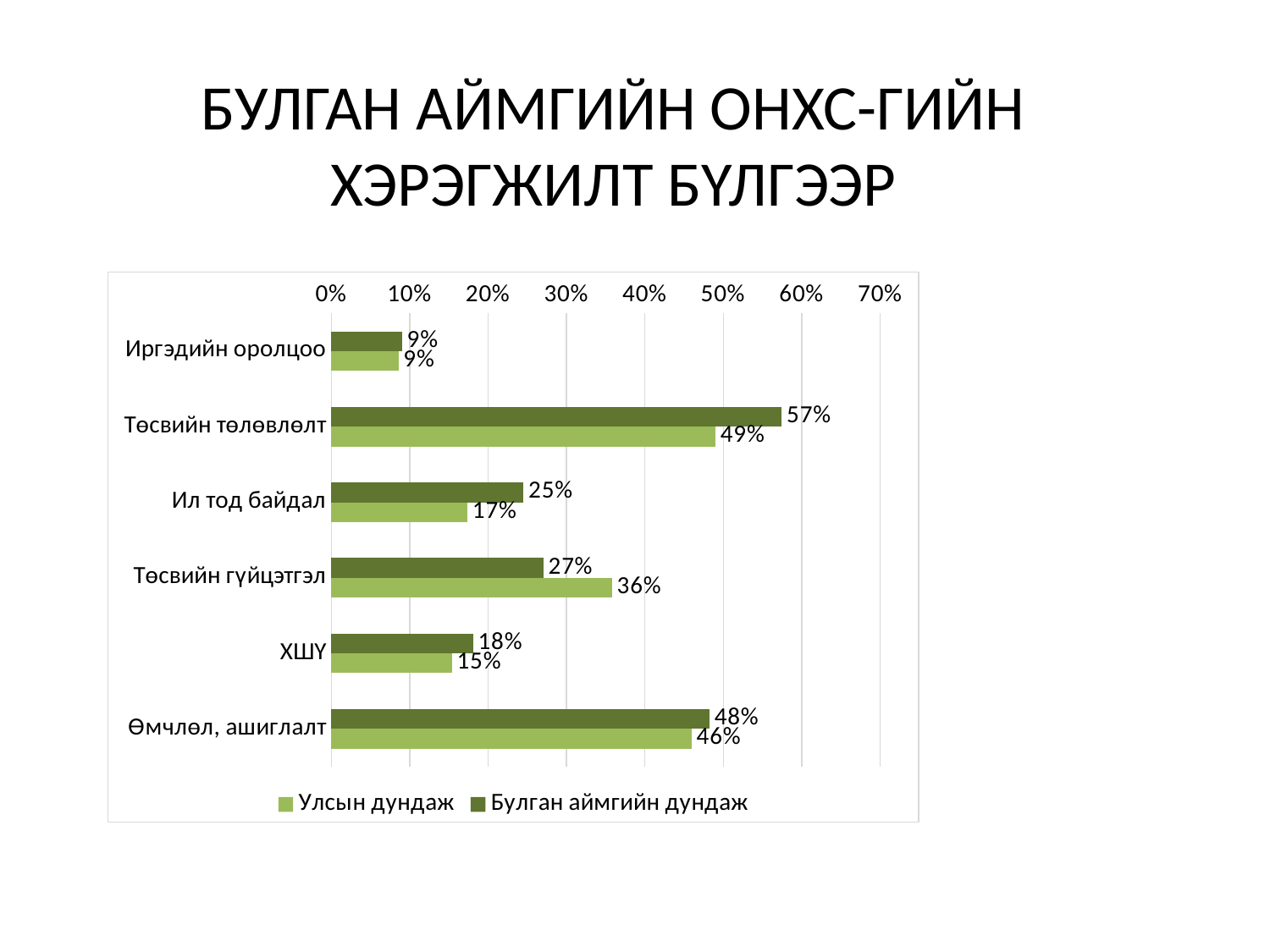
Which category has the highest value for Булган аймгийн дундаж? Төсвийн төлөвлөлт For Ил тод байдал, which is larger: Булган аймгийн дундаж or Улсын дундаж? Булган аймгийн дундаж Is the value of Булган аймгийн дундаж for Өмчлөл, ашиглалт greater or less than 40%? greater How many categories are shown on the chart? 6 Which category has the lowest value for Улсын дундаж? Иргэдийн оролцоо What is the value of Улсын дундаж for Ил тод байдал? 17% What is the difference between Булган аймгийн дундаж and Улсын дундаж for Төсвийн төлөвлөлт? 8% How many series does the legend list? 2 What is the difference between Улсын дундаж and Булган аймгийн дундаж for Төсвийн гүйцэтгэл? 9% What kind of chart is shown on the slide? Bar chart What is the value of Улсын дундаж for Төсвийн гүйцэтгэл? 36% What is the value of Булган аймгийн дундаж for Төсвийн төлөвлөлт? 57%